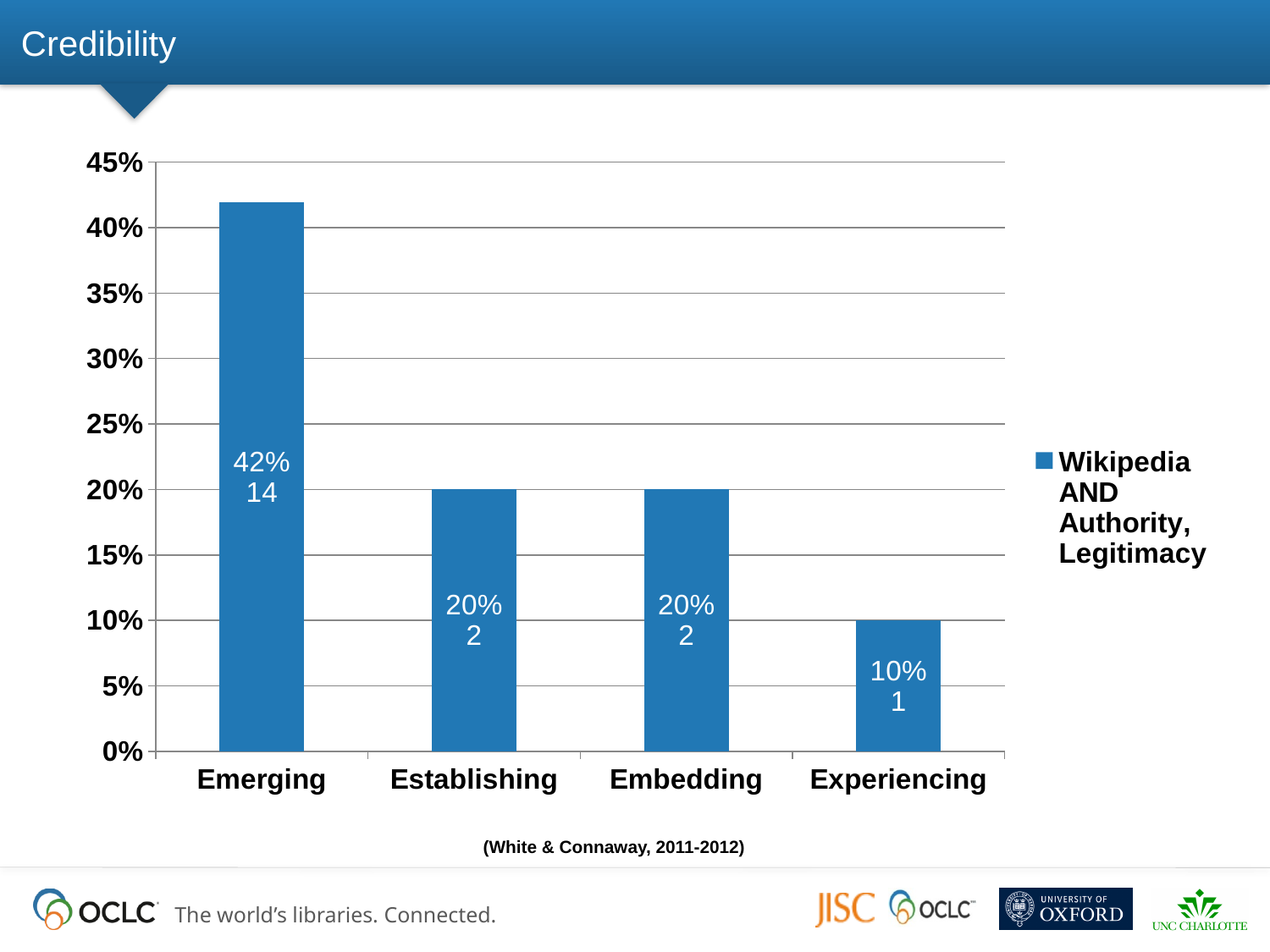
What percentage is shown for the Establishing category? 20% What kind of chart is shown on the slide? Bar chart How many series does the legend list? 1 What is the legend entry for the series? Wikipedia AND Authority, Legitimacy Is the value for Emerging greater or less than 40%? greater What is the difference in percentage points between Emerging and Embedding? 22% Which is larger, the value for Establishing or the value for Experiencing? Establishing What count is shown on the Experiencing bar? 1 What percentage is shown for the Emerging category? 42% Which category has the lowest value? Experiencing Which category has the highest value? Emerging How many categories are shown on the x axis? 4